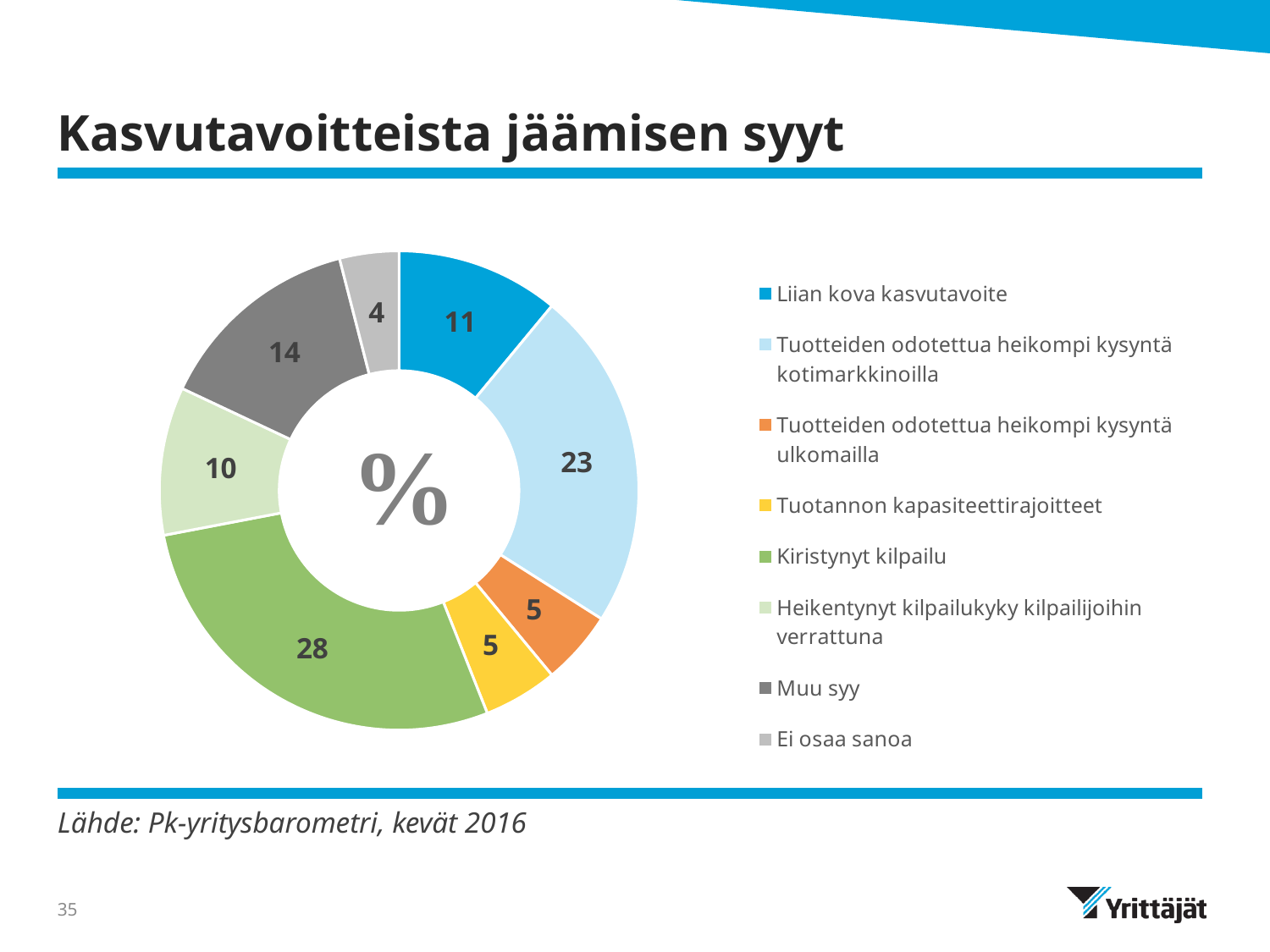
What is the title of the slide? Kasvutavoitteista jäämisen syyt What is the value for "Liian kova kasvutavoite"? 11 Which category has the largest share of the chart? Kiristynyt kilpailu Which category has the smallest share of the chart? Ei osaa sanoa What kind of chart is shown on the slide? Doughnut (pie) chart What is the value for "Kiristynyt kilpailu"? 28 How many categories does the legend list? 8 What is the difference between the values for "Kiristynyt kilpailu" and "Tuotteiden odotettua heikompi kysyntä kotimarkkinoilla"? 5 What is the value for "Muu syy"? 14 What is the value for "Ei osaa sanoa"? 4 Which is larger, the value for "Muu syy" or the value for "Heikentynyt kilpailukyky kilpailijoihin verrattuna"? Muu syy What is the value for "Tuotteiden odotettua heikompi kysyntä kotimarkkinoilla"? 23